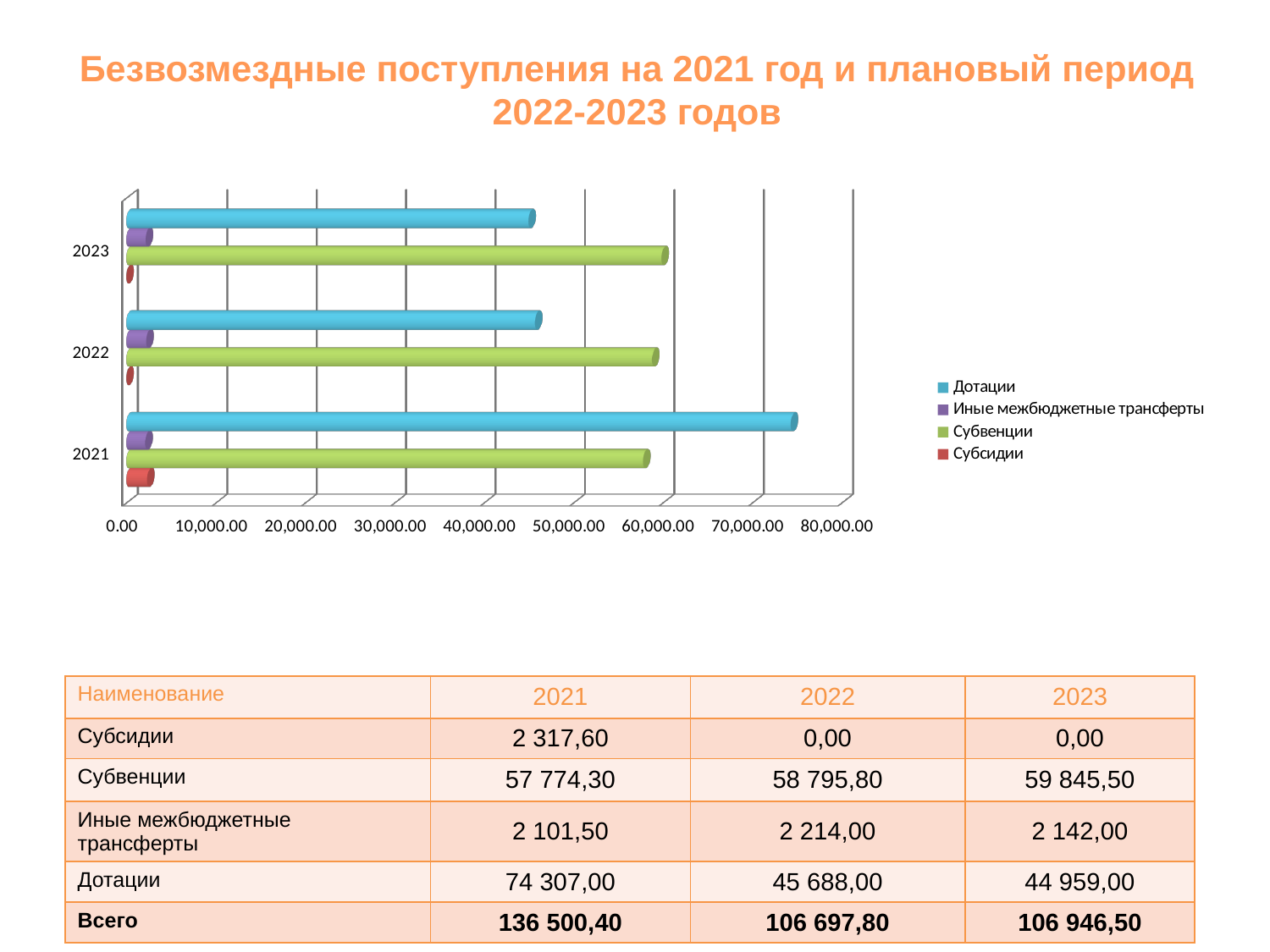
Is the value of Дотации for 2023 greater or less than 50,000.00? less What kind of chart is shown on the slide? bar chart In which year is the Субвенции bar the shortest? 2021 What is the difference between Дотации in 2021 and Дотации in 2022? 28 619,00 How many year categories are shown on the chart's vertical axis? 3 In which year is the Дотации bar the longest? 2021 How many series does the chart legend list? 4 What is the value of Субсидии for 2022? 0,00 Which colour represents Субвенции in the chart legend? green What is the value of Дотации for 2021? 74 307,00 What is the value of Субвенции for 2023? 59 845,50 Which is larger in 2022: Дотации or Субвенции? Субвенции